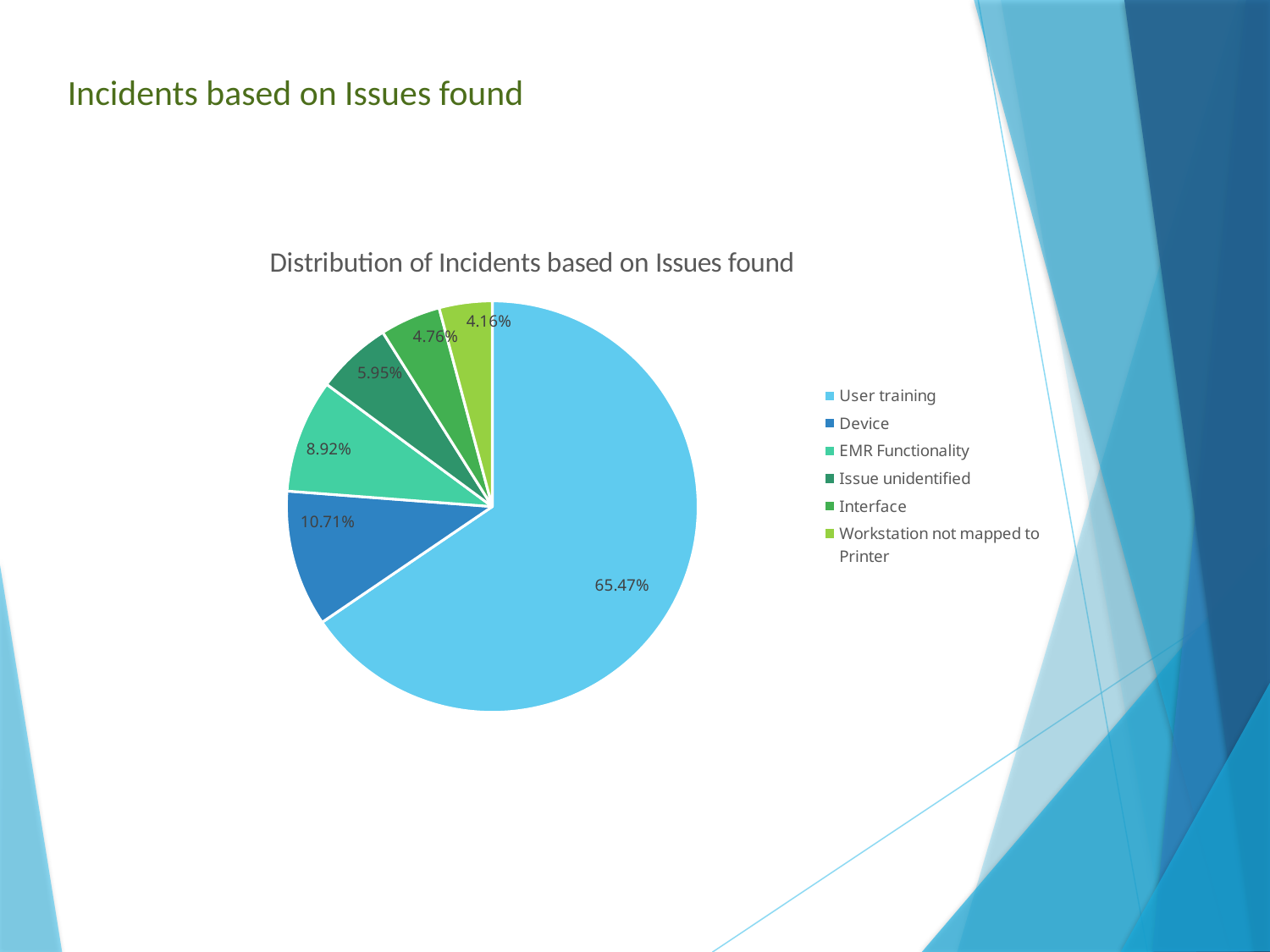
How many categories does the legend list? 6 What share of incidents is attributed to Device? 10.71% Which category has the smallest share of incidents? Workstation not mapped to Printer What share of incidents is attributed to Issue unidentified? 5.95% What is the difference between the shares for Device and EMR Functionality? 1.79% What is the chart's title? Distribution of Incidents based on Issues found What share of incidents is attributed to EMR Functionality? 8.92% What share of incidents is attributed to User training? 65.47% Which category has the largest share of incidents? User training What share of incidents is attributed to Workstation not mapped to Printer? 4.16% Which has a larger share, Device or Interface? Device What kind of chart is shown on the slide? pie chart